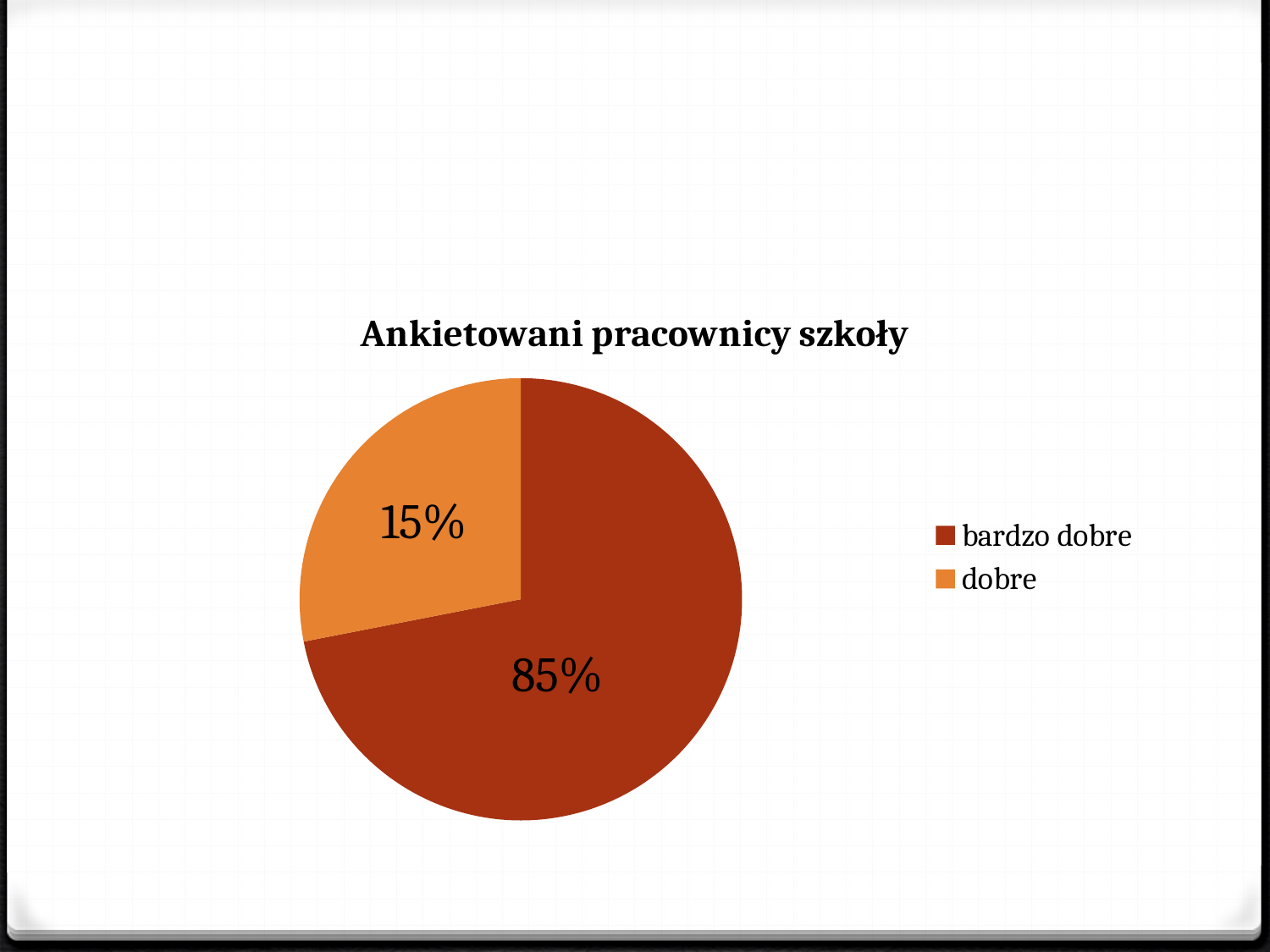
Which category has the largest slice of the pie? bardzo dobre What share of the pie is labelled "bardzo dobre"? 85% Which category is shown in the lighter orange colour? dobre What is the title of the chart? Ankietowani pracownicy szkoły Which category has the smallest slice of the pie? dobre What is the difference in percentage points between the "bardzo dobre" and "dobre" slices? 70 How many categories does the pie chart show? 2 What share of the pie is labelled "dobre"? 15% What kind of chart is shown on the slide? pie chart How many entries does the legend list? 2 Which slice is larger, "bardzo dobre" or "dobre"? bardzo dobre